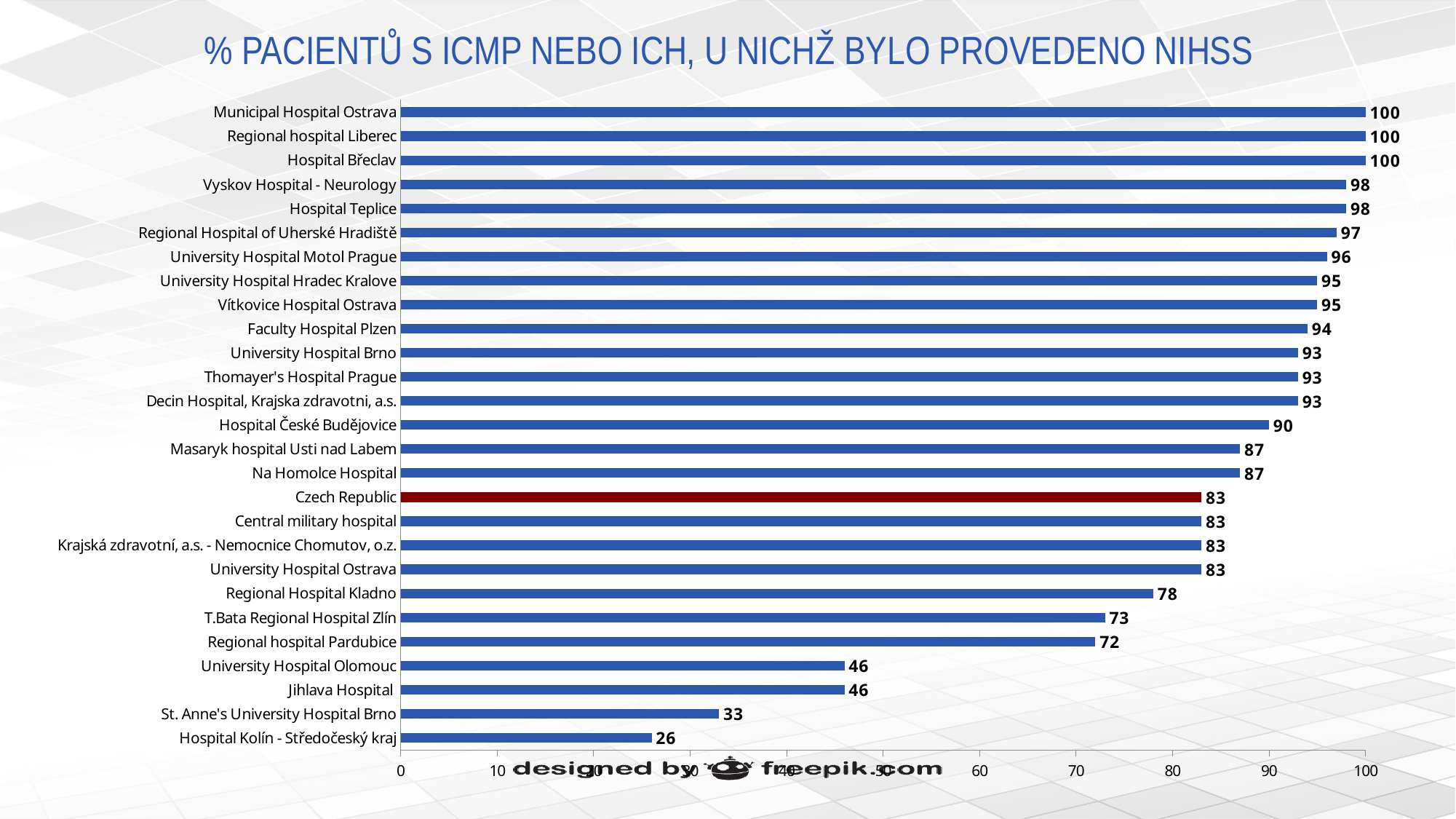
Which category has the lowest value? Hospital Kolín - Středočeský kraj What is the value for Czech Republic? 83 What is the value for Regional Hospital Kladno? 78 Which is larger, the value for T.Bata Regional Hospital Zlín or the value for Regional hospital Pardubice? T.Bata Regional Hospital Zlín Is the value for Masaryk hospital Usti nad Labem greater or less than 80? greater What is the title of the chart? % PACIENTŮ S ICMP NEBO ICH, U NICHŽ BYLO PROVEDENO NIHSS How many categories are shown in the chart? 27 What kind of chart is shown on the slide? bar chart What is the value for University Hospital Olomouc? 46 What is the value for Hospital Teplice? 98 Which category's bar is coloured dark red instead of blue? Czech Republic What is the difference between the values for Hospital České Budějovice and St. Anne's University Hospital Brno? 57